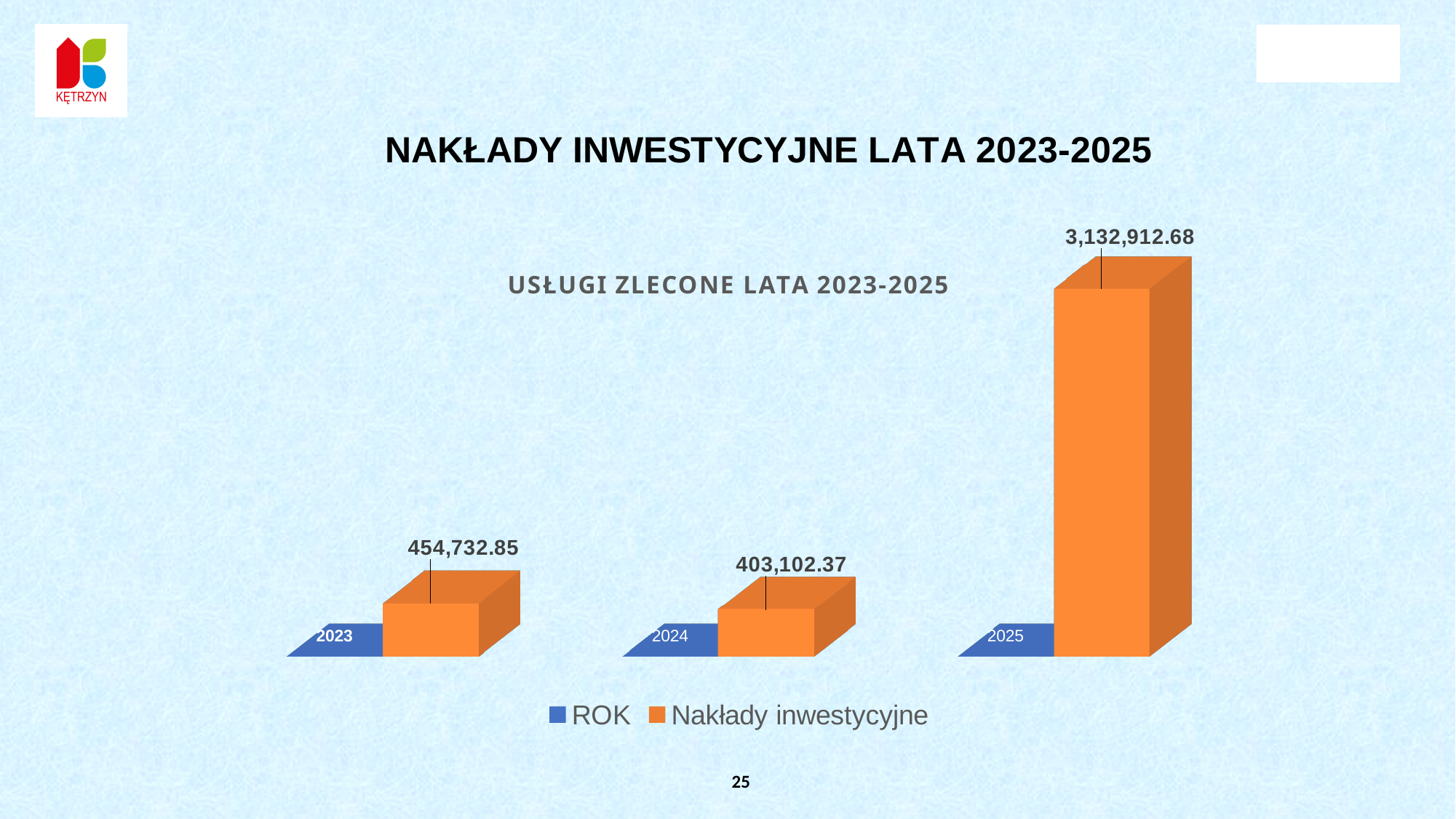
What is the value of Nakłady inwestycyjne for 2024? 403,102.37 What is the title of the chart? USŁUGI ZLECONE LATA 2023-2025 How many years (categories) are shown on the chart? 3 What kind of chart is shown on the slide? Bar chart What is the value of Nakłady inwestycyjne for 2025? 3,132,912.68 Which year has the highest Nakłady inwestycyjne value? 2025 What is the difference between the Nakłady inwestycyjne values for 2025 and 2023? 2,678,179.83 Which is larger, the Nakłady inwestycyjne value for 2023 or for 2024? 2023 How many series does the legend list? 2 What is the value of Nakłady inwestycyjne for 2023? 454,732.85 What is the difference between the Nakłady inwestycyjne values for 2023 and 2024? 51,630.48 Which year has the lowest Nakłady inwestycyjne value? 2024